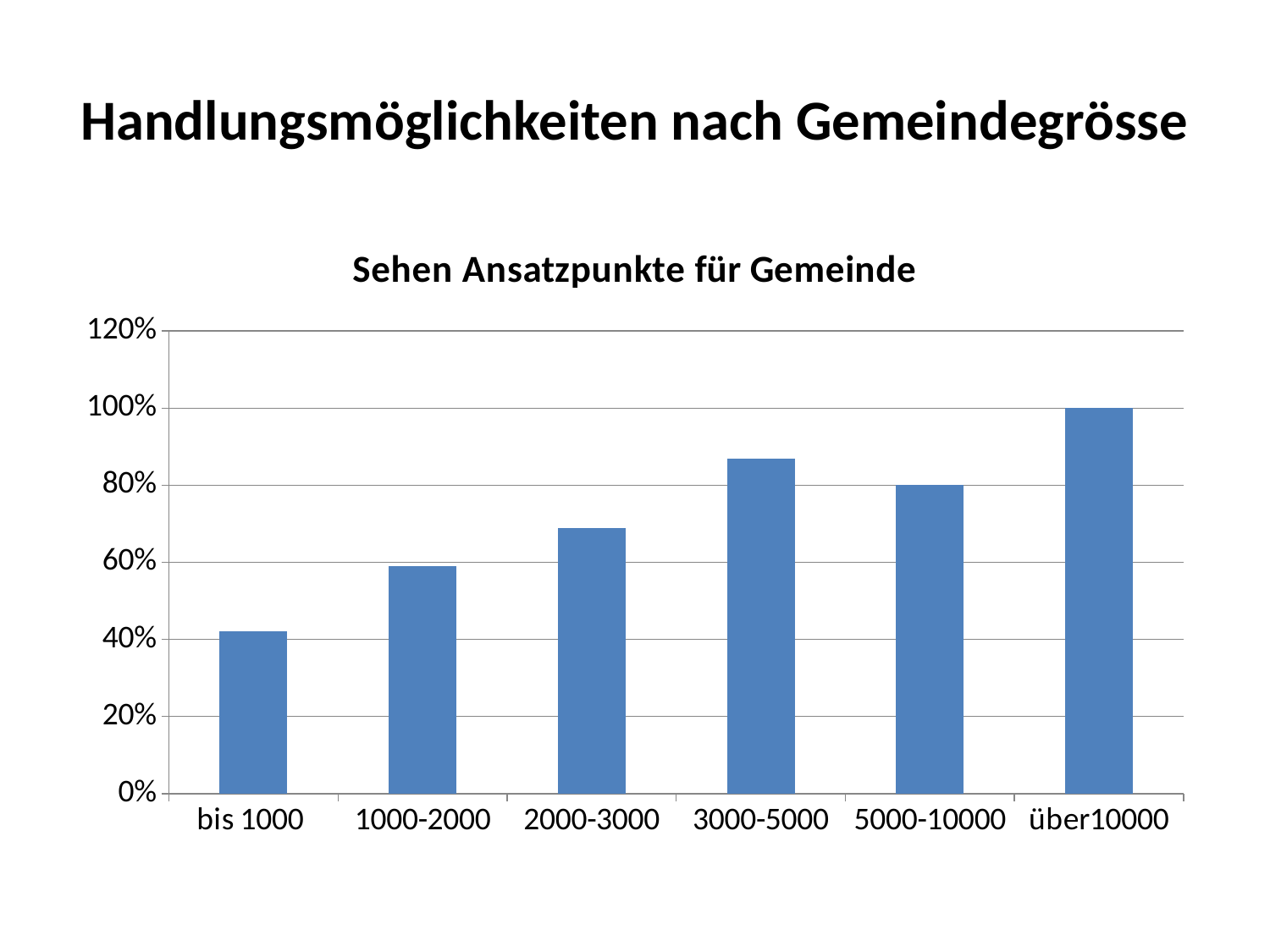
Which category has the highest value? über10000 What type of chart is shown on the slide? bar chart Which is larger, the value for 3000-5000 or the value for 5000-10000? 3000-5000 How many categories are shown on the x axis of the chart? 6 What is the title of the chart? Sehen Ansatzpunkte für Gemeinde Is the value for 3000-5000 greater or less than 80%? greater Which category has the lowest value? bis 1000 Is the value for 2000-3000 greater or less than 60%? greater Which is larger, the value for bis 1000 or the value for 2000-3000? 2000-3000 Is the value for 1000-2000 greater or less than 40%? greater What is the value for über10000? 100%